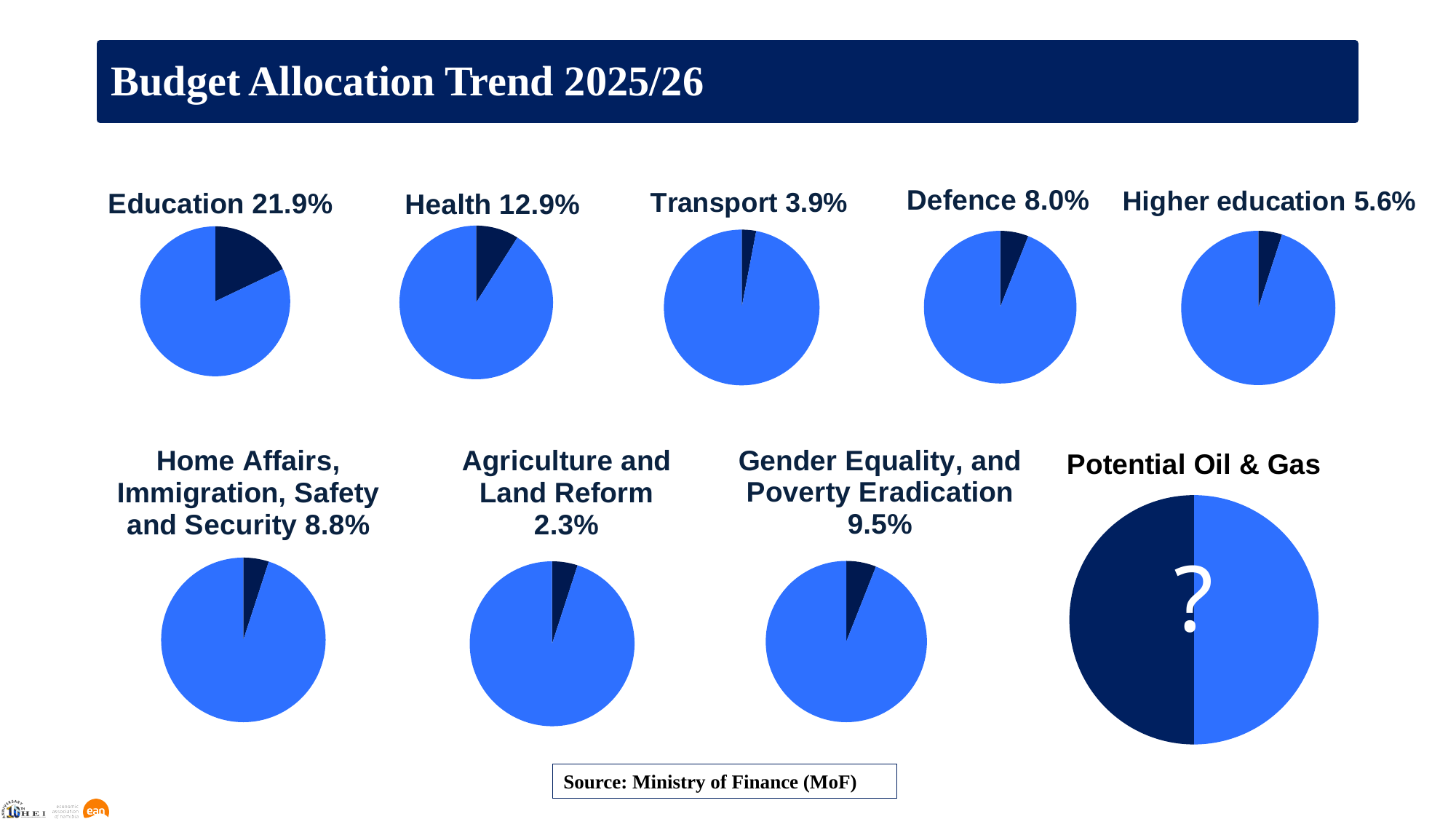
What is the difference between the Education share and the Health share? 9.0% What share of the budget is allocated to Education according to the slide? 21.9% What kind of chart is used to show each sector's budget share on this slide? Pie chart How many pie charts are shown on the slide? 9 What percentage is shown for Gender Equality, and Poverty Eradication? 9.5% Which has a larger budget share, Defence or Home Affairs, Immigration, Safety and Security? Home Affairs, Immigration, Safety and Security Which sector has the smallest budget share among the pie charts with a printed percentage? Agriculture and Land Reform What symbol is shown inside the Potential Oil & Gas pie chart instead of a percentage? ? Which sector has the largest budget share among the pie charts with a printed percentage? Education What is the difference between the Defence share and the Higher education share? 2.4% What percentage is shown for Health? 12.9% What is the budget share shown for Transport? 3.9%